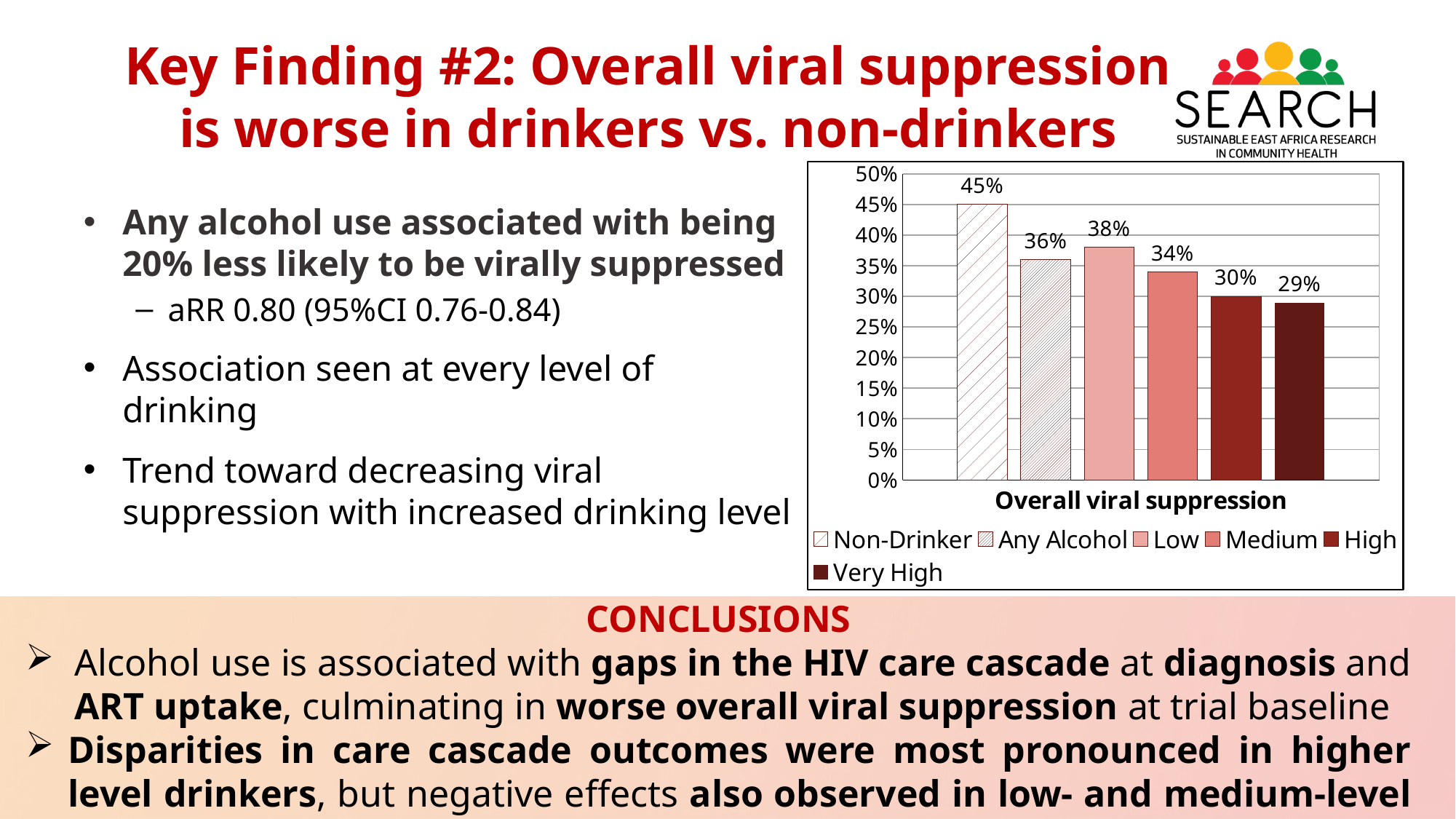
How many series does the legend list? 6 What is the overall viral suppression value for Non-Drinker? 45% What is the difference in overall viral suppression between Low and Medium? 4% What is the category label shown on the x axis of the chart? Overall viral suppression What is the overall viral suppression value for Any Alcohol? 36% Which series has the highest overall viral suppression? Non-Drinker Which has a higher overall viral suppression, Low or High? Low What is the overall viral suppression value for Very High? 29% Which series has the lowest overall viral suppression? Very High What is the difference in overall viral suppression between Non-Drinker and Very High? 16% What kind of chart is shown on the slide? Bar chart Is the value for Medium greater or less than 30%? greater